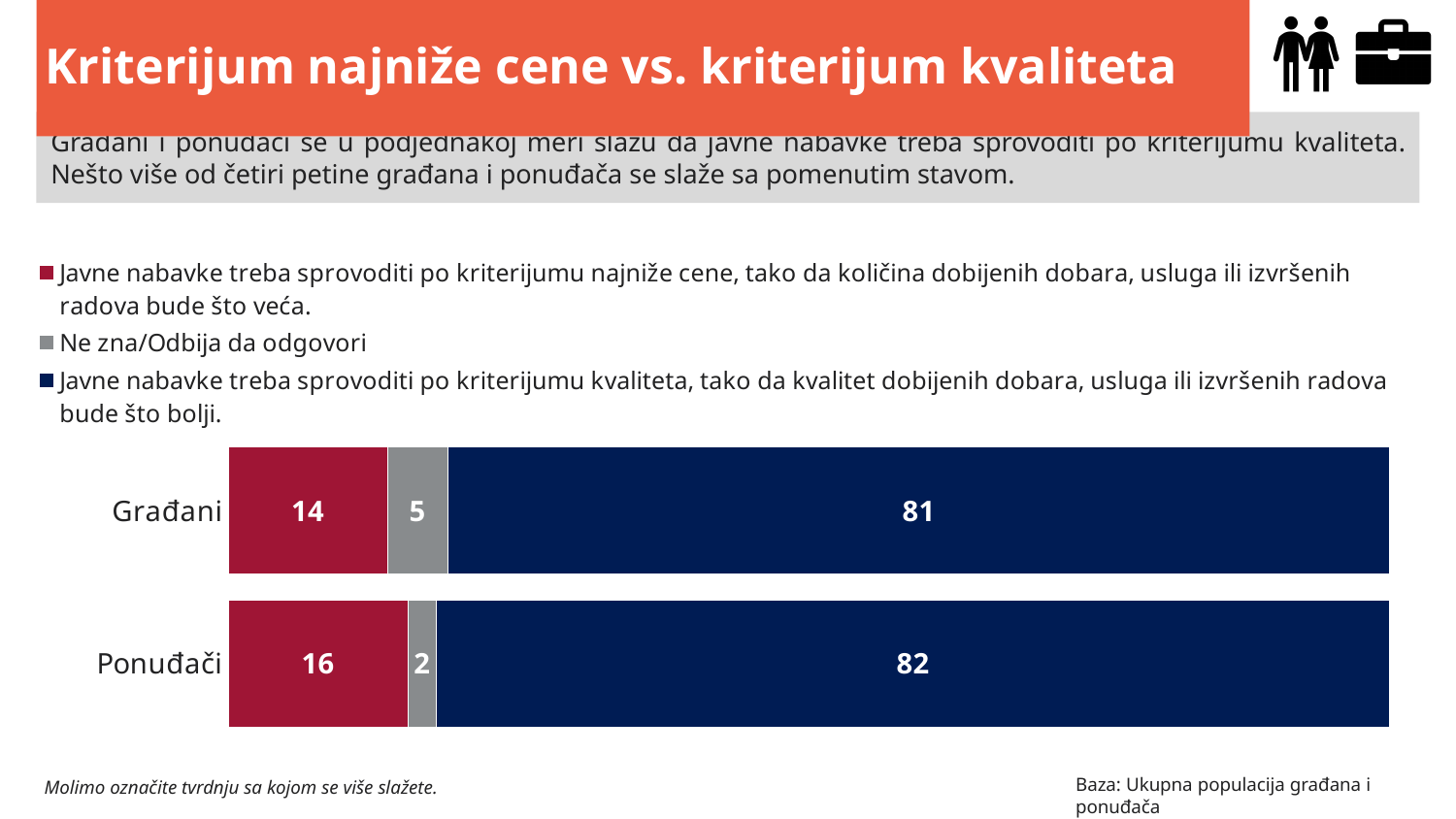
What is the value for Ponuđači in the 'kriterijum najniže cene' (red) series? 16 How many categories are plotted on the chart? 2 What kind of chart is shown on the slide? Stacked bar chart What is the value for Građani in the 'kriterijum kvaliteta' (dark blue) series? 81 What is the value for Ponuđači in the 'Ne zna/Odbija da odgovori' series? 2 What is the total of the stacked bar for Građani? 100 Which category has the lower value in the 'Ne zna/Odbija da odgovori' series? Ponuđači How many series does the legend list? 3 Which category has the higher value in the 'kriterijum najniže cene' (red) series? Ponuđači What is the difference between the 'kriterijum najniže cene' values for Ponuđači and Građani? 2 What is the value for Građani in the 'Ne zna/Odbija da odgovori' series? 5 Which colour represents the 'Ne zna/Odbija da odgovori' series? Gray